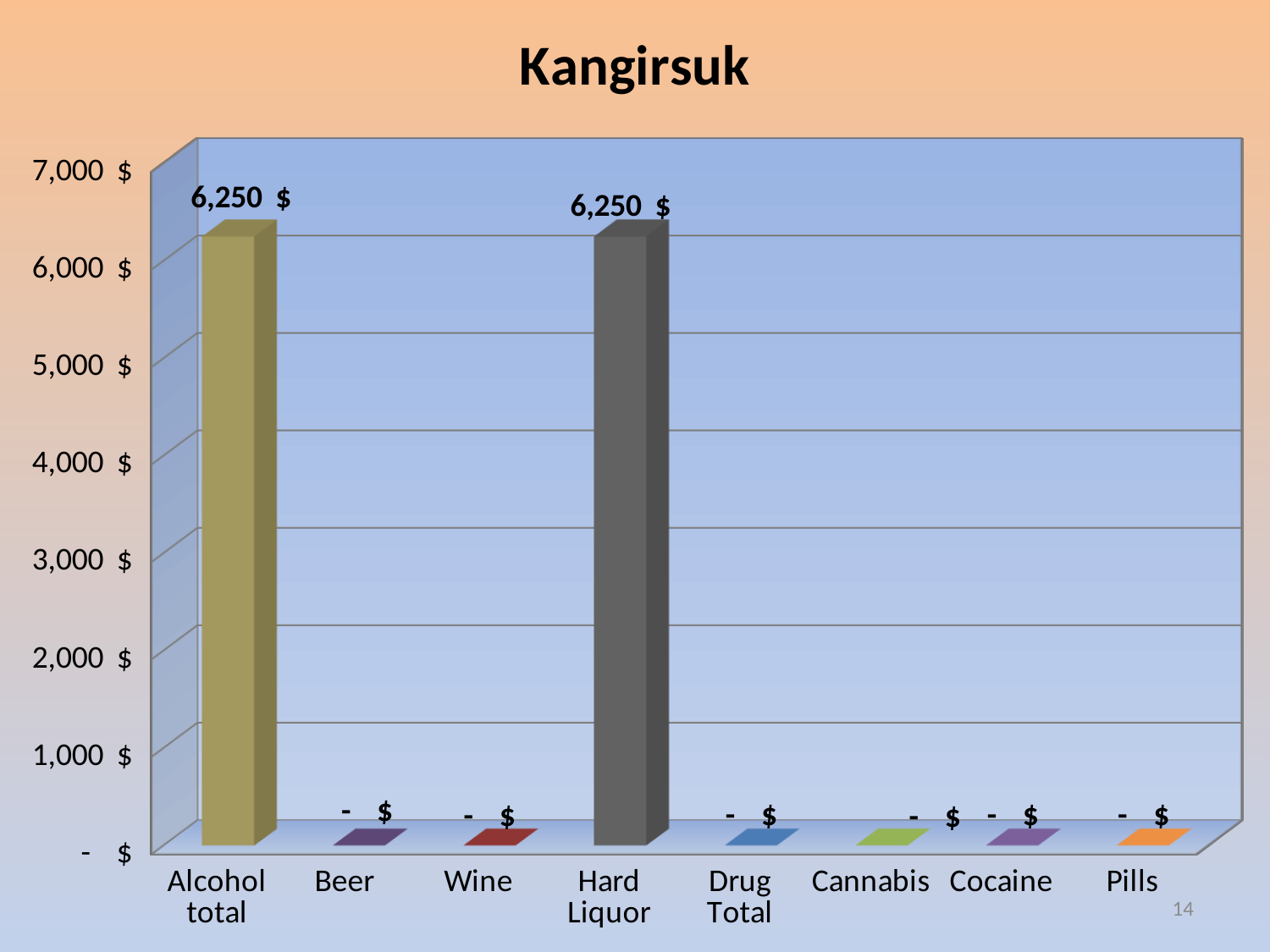
Which is larger, the value for Alcohol total or the value for Cocaine? Alcohol total Which is larger, the value for Hard Liquor or the value for Wine? Hard Liquor What value is shown for Beer? - $ What is the value for Hard Liquor? 6,250 $ What is the difference between the value for Alcohol total and the value for Hard Liquor? 0 $ How many categories are shown on the x axis? 8 What value is shown for Drug Total? - $ What is the title of the chart? Kangirsuk What is the value for Alcohol total? 6,250 $ Is the value for Hard Liquor greater or less than 6,000 $? greater What value is shown for Cannabis? - $ What kind of chart is shown on the slide? bar chart